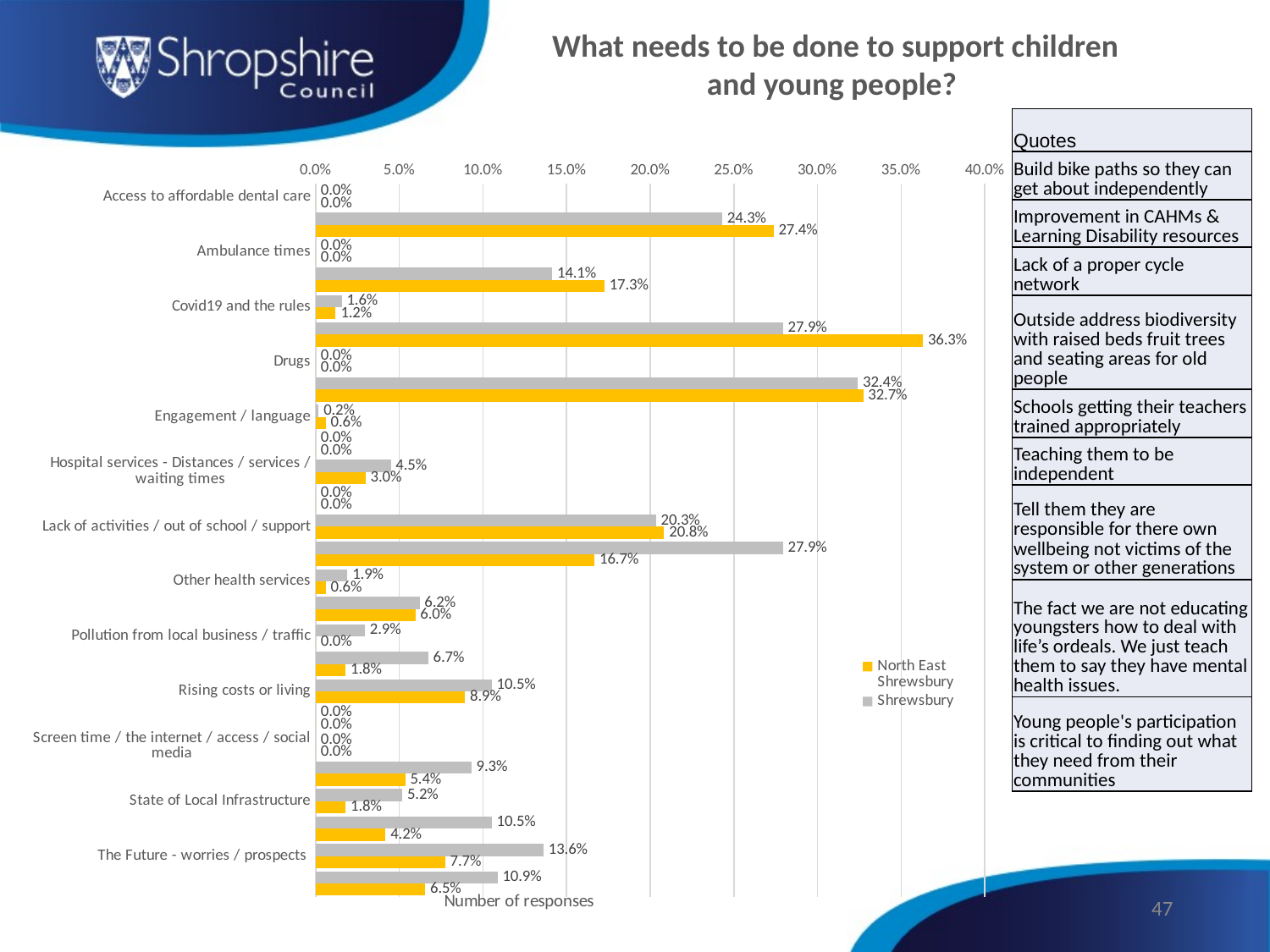
What is the Shrewsbury value for 'The Future - worries / prospects'? 13.6% How many series does the chart legend list? 2 What are the two series named in the chart legend? North East Shrewsbury and Shrewsbury What kind of chart is shown on the slide? Bar chart What is the difference between the Shrewsbury and North East Shrewsbury values for 'The Future - worries / prospects'? 5.9 percentage points What is the Shrewsbury value for 'Rising costs or living'? 10.5% For 'Hospital services - Distances / services / waiting times', which series has the larger value, Shrewsbury or North East Shrewsbury? Shrewsbury What is the label on the horizontal axis of the chart? Number of responses What is the Shrewsbury value for 'State of Local Infrastructure'? 5.2% What is the North East Shrewsbury value for 'Rising costs or living'? 8.9% What is the largest value labelled anywhere on the chart? 36.3% What is the North East Shrewsbury value for 'Lack of activities / out of school / support'? 20.8%